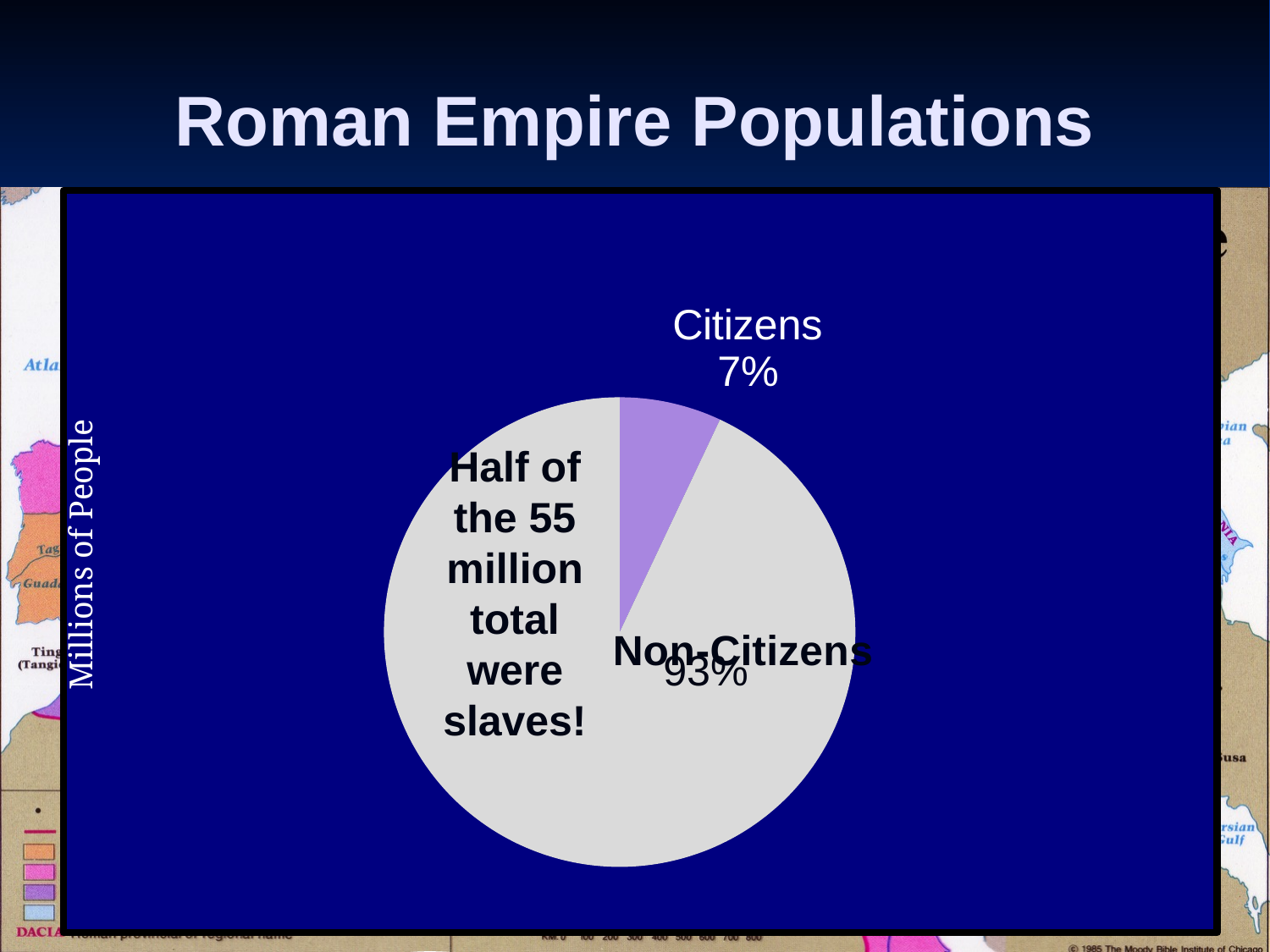
What is the title of the slide containing the pie chart? Roman Empire Populations What colour is the Citizens slice of the pie? purple What kind of chart is shown on the slide? pie chart Which is larger, the Citizens slice or the Non-Citizens slice? Non-Citizens What share of the pie is labelled Citizens? 7% What is the difference in percentage points between the Non-Citizens share and the Citizens share? 86 How many slices does the pie chart have? 2 Which slice of the pie is the largest? Non-Citizens Which slice of the pie is the smallest? Citizens According to the text on the chart, what was the total population in millions? 55 million What share of the pie is labelled Non-Citizens? 93%